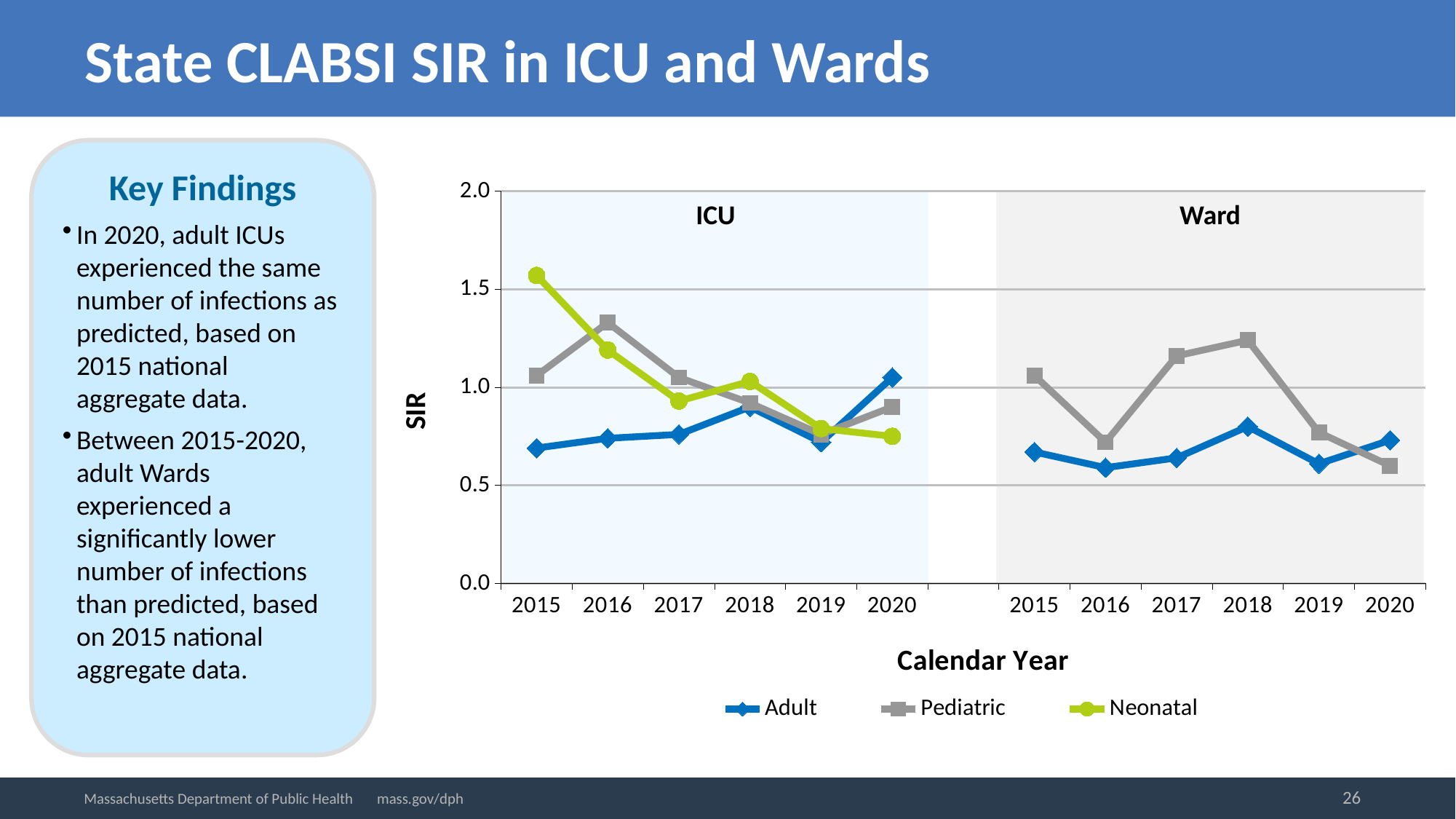
How many calendar years are plotted in the ICU panel? 6 In the Ward panel for 2020, which series has the higher SIR, Adult or Pediatric? Adult What kind of chart is shown on the slide? Line chart In the Ward panel, is the Adult value for 2016 greater or less than 1.0? less In the ICU panel, is the Neonatal value for 2015 greater or less than 1.5? greater In the ICU panel, which year has the highest Neonatal SIR? 2015 In the ICU panel, is the Pediatric value for 2016 greater or less than 1.0? greater In the ICU panel, which year has the highest Pediatric SIR? 2016 In the Ward panel, which year has the highest Pediatric SIR? 2018 In the ICU panel for 2015, which series has the higher SIR, Neonatal or Adult? Neonatal In the ICU panel, does the Neonatal SIR generally rise or fall from 2015 to 2020? Fall How many series does the legend list? 3